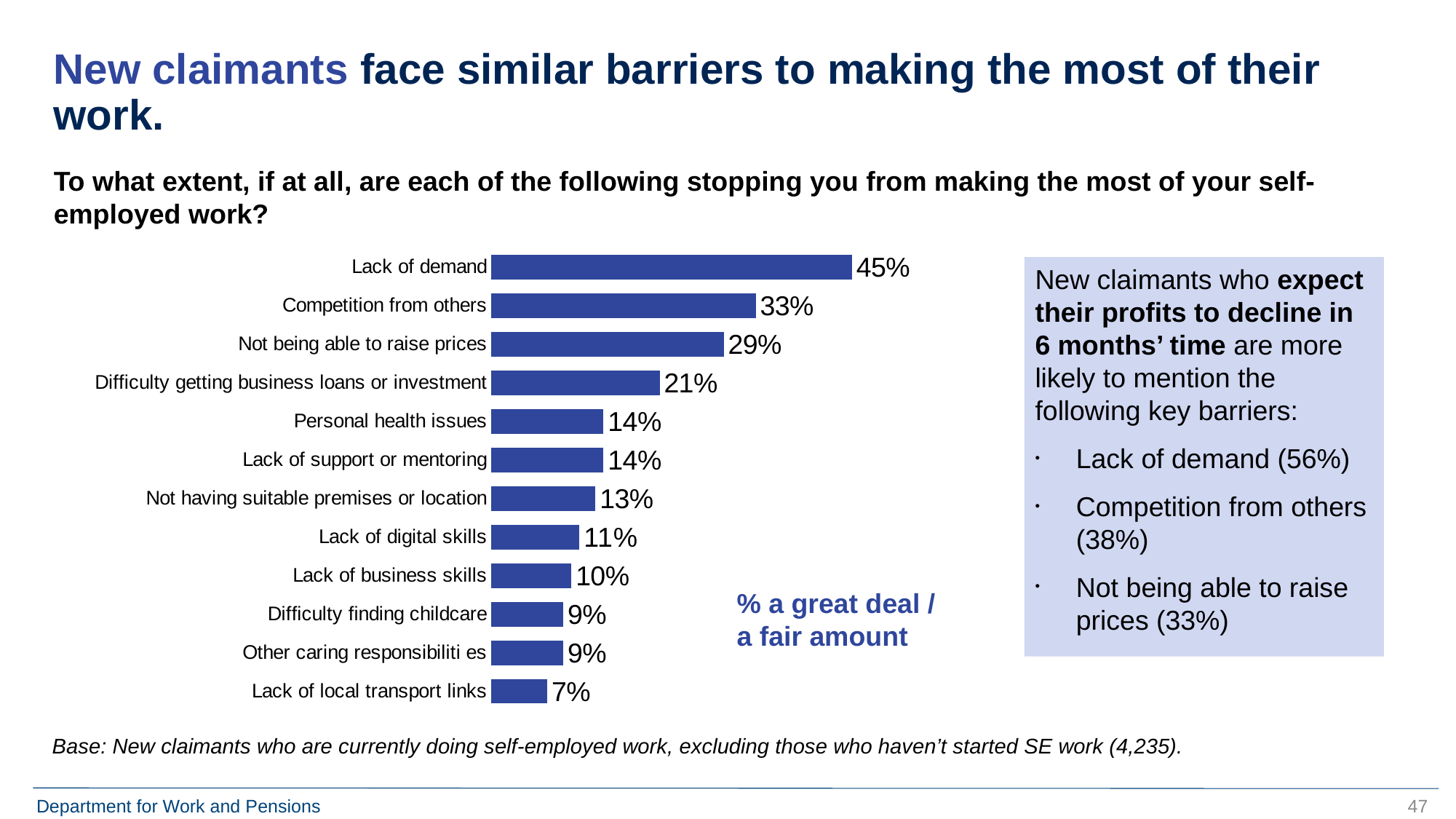
What measure do the bars represent, according to the label next to the chart? % a great deal / a fair amount Which barrier has the highest percentage in the chart? Lack of demand Do the values rise or fall going from the top bar to the bottom bar? Fall Which barrier has the lowest percentage in the chart? Lack of local transport links What is the difference in percentage points between 'Lack of demand' and 'Competition from others'? 12 Which is larger: the value for 'Personal health issues' or the value for 'Lack of digital skills'? Personal health issues What is the difference in percentage points between 'Not being able to raise prices' and 'Lack of business skills'? 19 What is the value shown for 'Difficulty getting business loans or investment'? 21% How many barriers (categories) are shown in the chart? 12 What type of chart is used on this slide? Bar chart What percentage of new claimants say lack of demand stops them a great deal or a fair amount? 45% What is the value shown for 'Lack of digital skills'? 11%